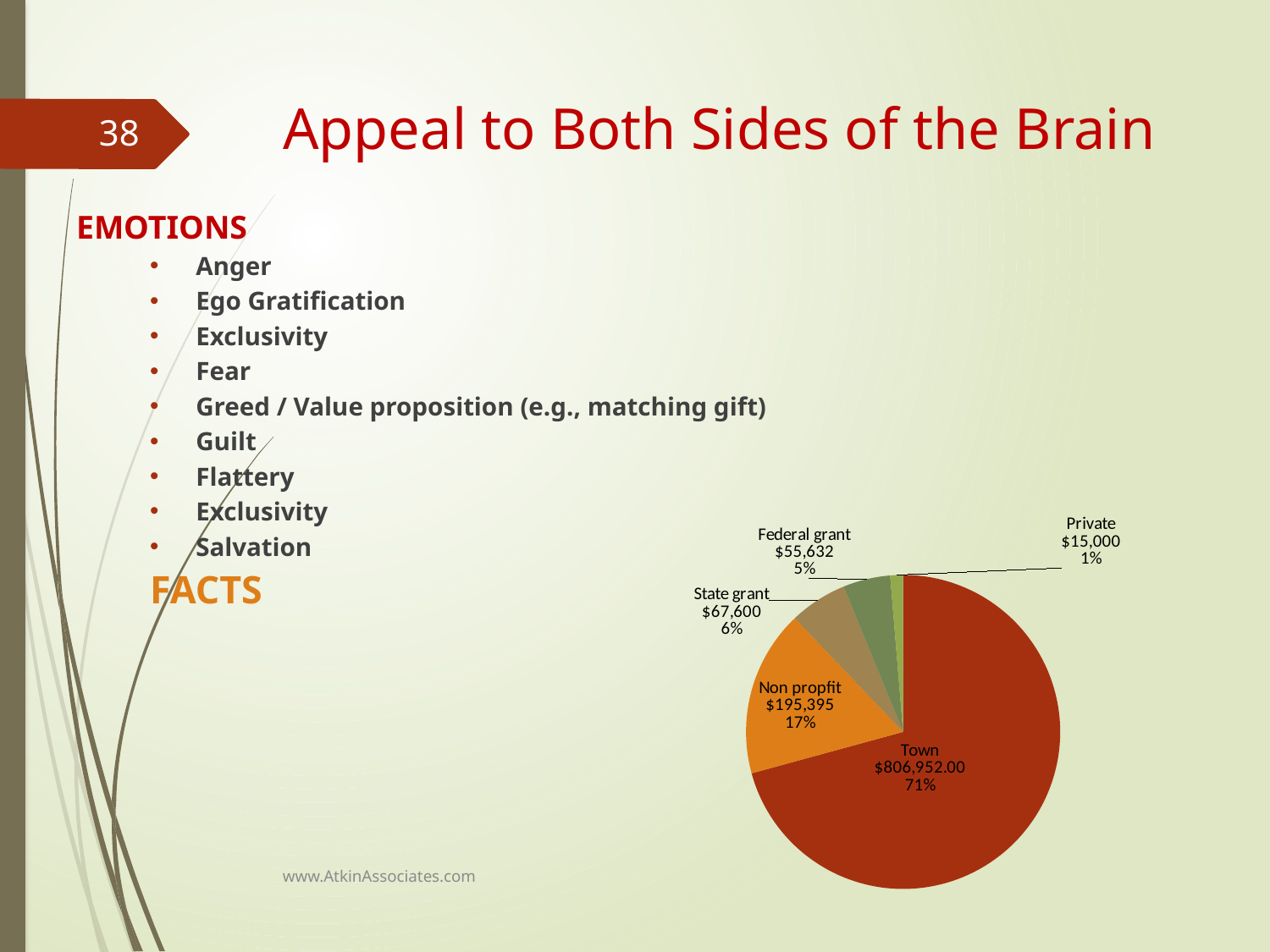
What share of the pie does Non propfit represent? 17% What share of the pie does Town represent? 71% How many slices does the pie chart have? 5 What is the difference between the State grant and Federal grant values in the pie chart? $11,968 What is the value for State grant in the pie chart? $67,600 What is the value for Federal grant in the pie chart? $55,632 What type of chart is shown on the slide? pie chart Which category has the largest slice of the pie chart? Town What is the value for Town in the pie chart? $806,952.00 What is the value for Non propfit in the pie chart? $195,395 What is the value for Private in the pie chart? $15,000 Which category has the smallest slice of the pie chart? Private